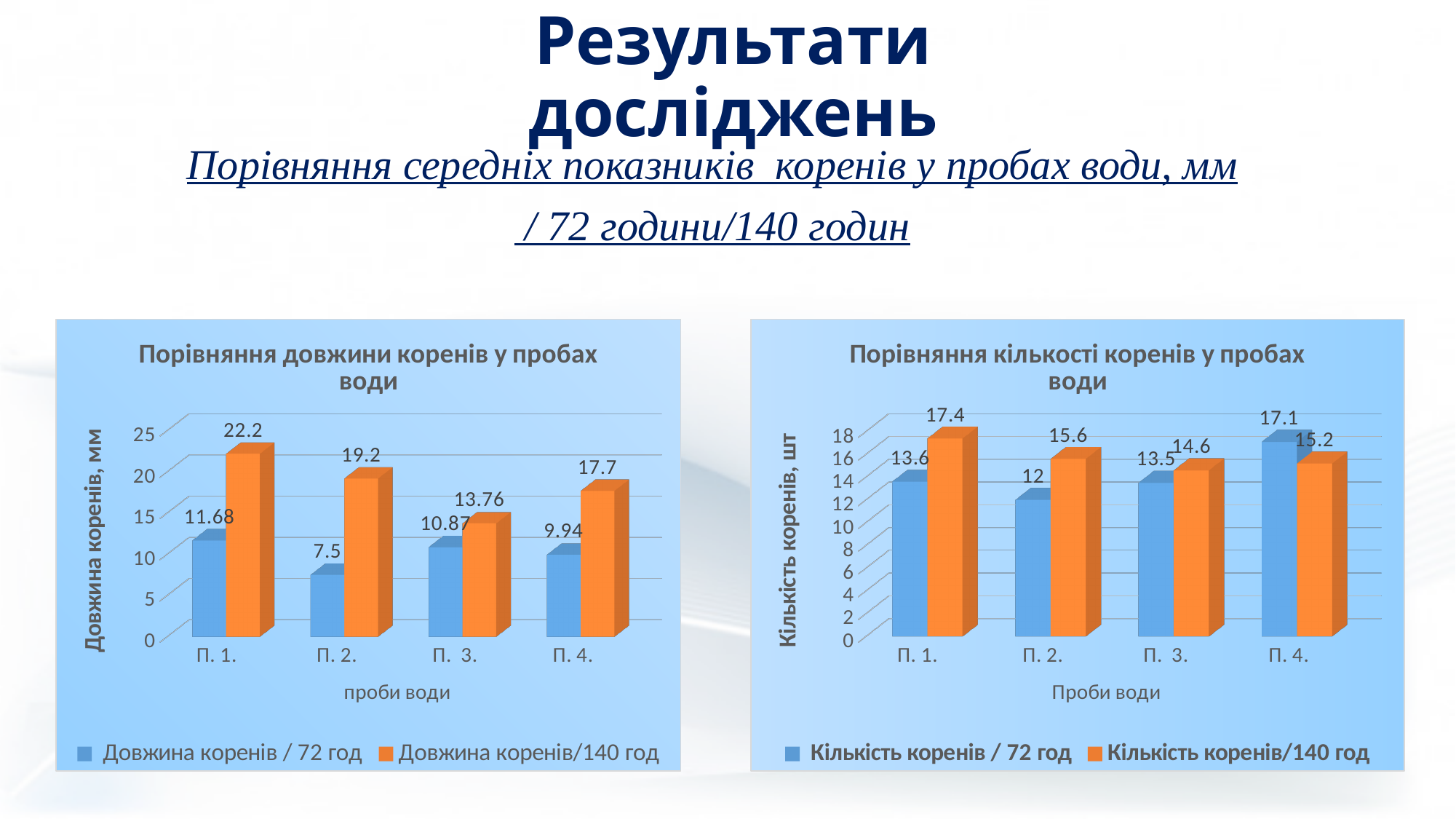
In the left chart (Порівняння довжини коренів у пробах води), what is the value of Довжина коренів / 72 год for П. 2.? 7.5 In the left chart (Порівняння довжини коренів у пробах води), what is the difference between Довжина коренів/140 год and Довжина коренів / 72 год for П. 3.? 2.89 In the right chart (Порівняння кількості коренів у пробах води), what is the difference between Кількість коренів/140 год and Кількість коренів / 72 год for П. 2.? 3.6 In the right chart (Порівняння кількості коренів у пробах води), how many water samples are shown on the x axis? 4 In the left chart (Порівняння довжини коренів у пробах води), how many series does the legend list? 2 In the left chart (Порівняння довжини коренів у пробах води), which sample has the lowest value for Довжина коренів / 72 год? П. 2. In the right chart (Порівняння кількості коренів у пробах води), what is the value of Кількість коренів / 72 год for П. 4.? 17.1 In the right chart (Порівняння кількості коренів у пробах води), which sample has the highest value for Кількість коренів/140 год? П. 1. In the left chart (Порівняння довжини коренів у пробах води), what is the value of Довжина коренів/140 год for П. 1.? 22.2 In the right chart (Порівняння кількості коренів у пробах води), which is larger for П. 4.: Кількість коренів / 72 год or Кількість коренів/140 год? Кількість коренів / 72 год What type of chart is the left chart (Порівняння довжини коренів у пробах води)? Bar chart What is the y-axis label of the right chart (Порівняння кількості коренів у пробах води)? Кількість коренів, шт